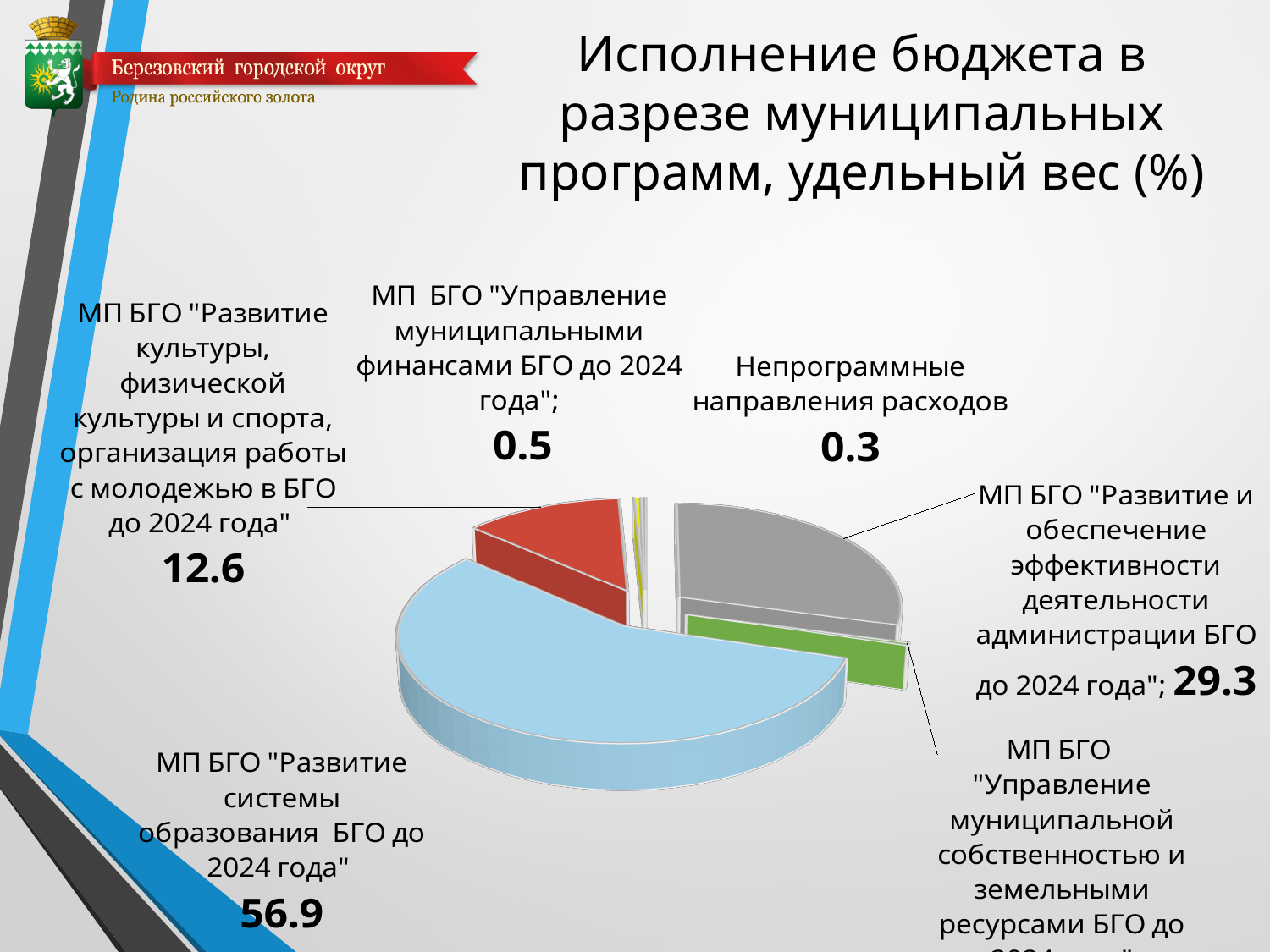
What is the share of МП БГО "Развитие и обеспечение эффективности деятельности администрации БГО до 2024 года"? 29.3 What is the share of Непрограммные направления расходов? 0.3 What is the title of the chart? Исполнение бюджета в разрезе муниципальных программ, удельный вес (%) Which program has the largest share of the budget? МП БГО "Развитие системы образования БГО до 2024 года" What is the difference between the shares of the education program (56.9) and the administration program (29.3)? 27.6 What is the share of МП БГО "Развитие культуры, физической культуры и спорта, организация работы с молодежью в БГО до 2024 года"? 12.6 What is the share of МП БГО "Управление муниципальными финансами БГО до 2024 года"? 0.5 What colour is the largest slice of the pie? light blue What is the share of МП БГО "Развитие системы образования БГО до 2024 года"? 56.9 What type of chart is shown on the slide? pie chart Which is larger: the share of МП БГО "Управление муниципальными финансами БГО до 2024 года" or Непрограммные направления расходов? МП БГО "Управление муниципальными финансами БГО до 2024 года" What is the difference between the shares of the administration program (29.3) and the culture and sport program (12.6)? 16.7